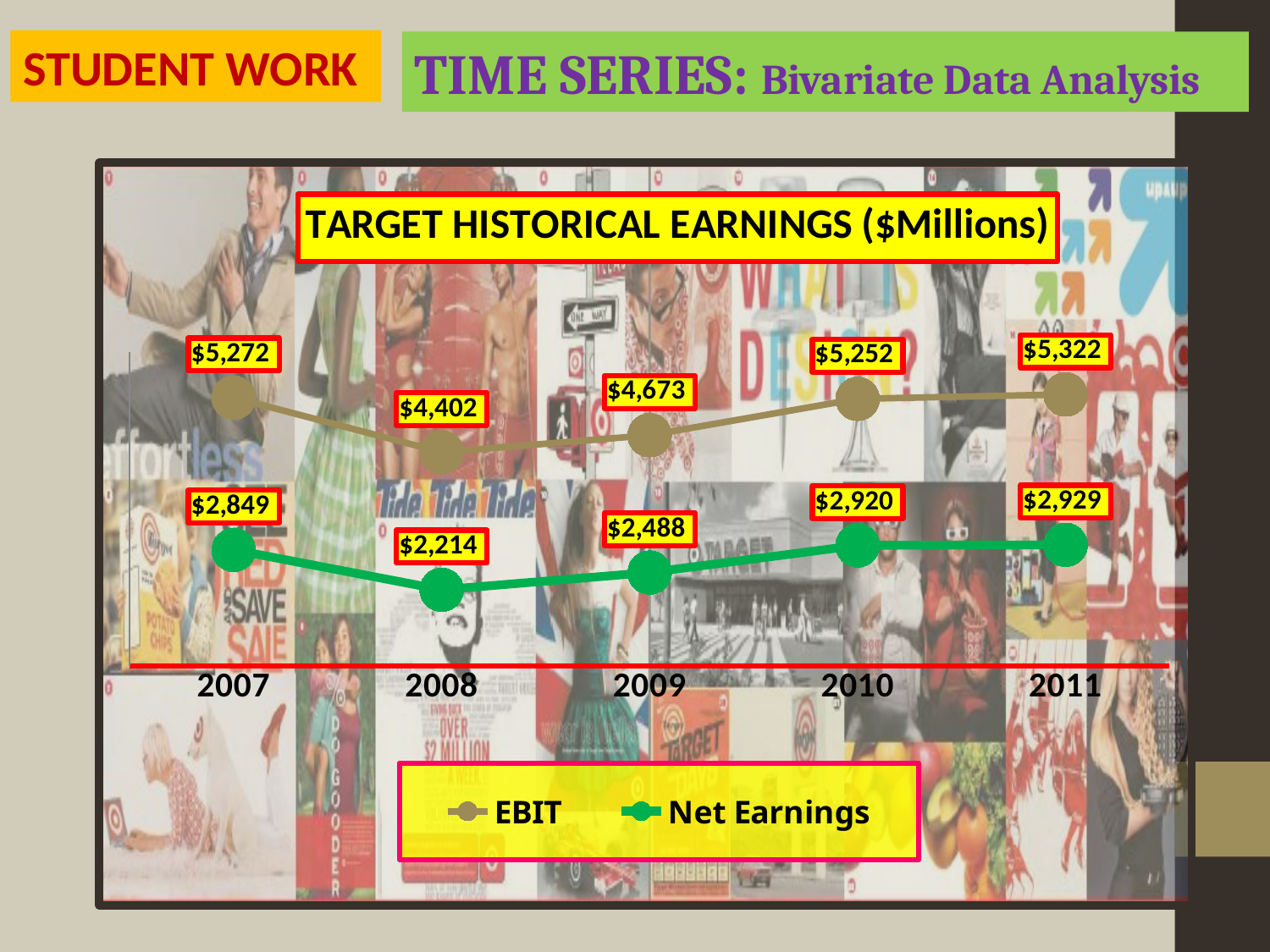
What is the Net Earnings value for 2010? $2,920 What is the EBIT value for 2007? $5,272 What is the EBIT value for 2009? $4,673 What is the difference between EBIT and Net Earnings in 2010? $2,332 In which year is EBIT highest? 2011 How many years are shown on the x axis? 5 In which year is EBIT lowest? 2008 Which is larger, Net Earnings in 2009 or Net Earnings in 2007? Net Earnings in 2007 How many series does the legend list? 2 What kind of chart is shown on the slide? Line chart What is the difference between EBIT in 2007 and EBIT in 2008? $870 In which year is Net Earnings lowest? 2008